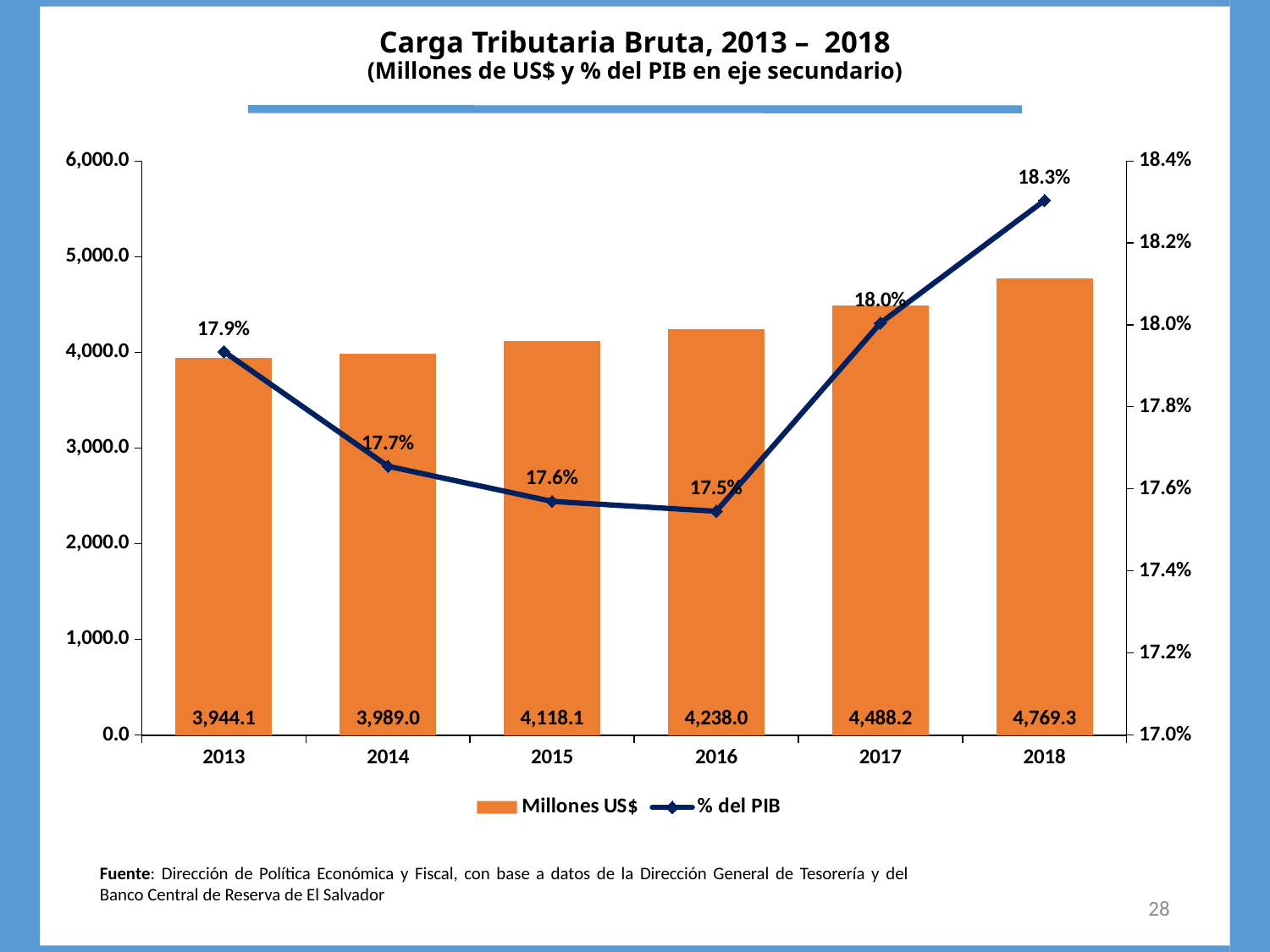
Is the Millones US$ value for 2017 greater or less than 4,000.0? greater Which year has a larger Millones US$ value, 2014 or 2016? 2016 How many years are shown on the x axis? 6 Which year has the lowest % del PIB value? 2016 What is the title of the chart? Carga Tributaria Bruta, 2013 – 2018 What is the value of Millones US$ for 2015? 4,118.1 What is the % del PIB value for 2016? 17.5% Which year has the highest Millones US$ value? 2018 How many series does the legend list? 2 Do the Millones US$ values rise or fall from 2013 to 2018? rise What kind of chart is used for the Millones US$ series? bar chart What is the difference in Millones US$ between 2018 and 2013? 825.2